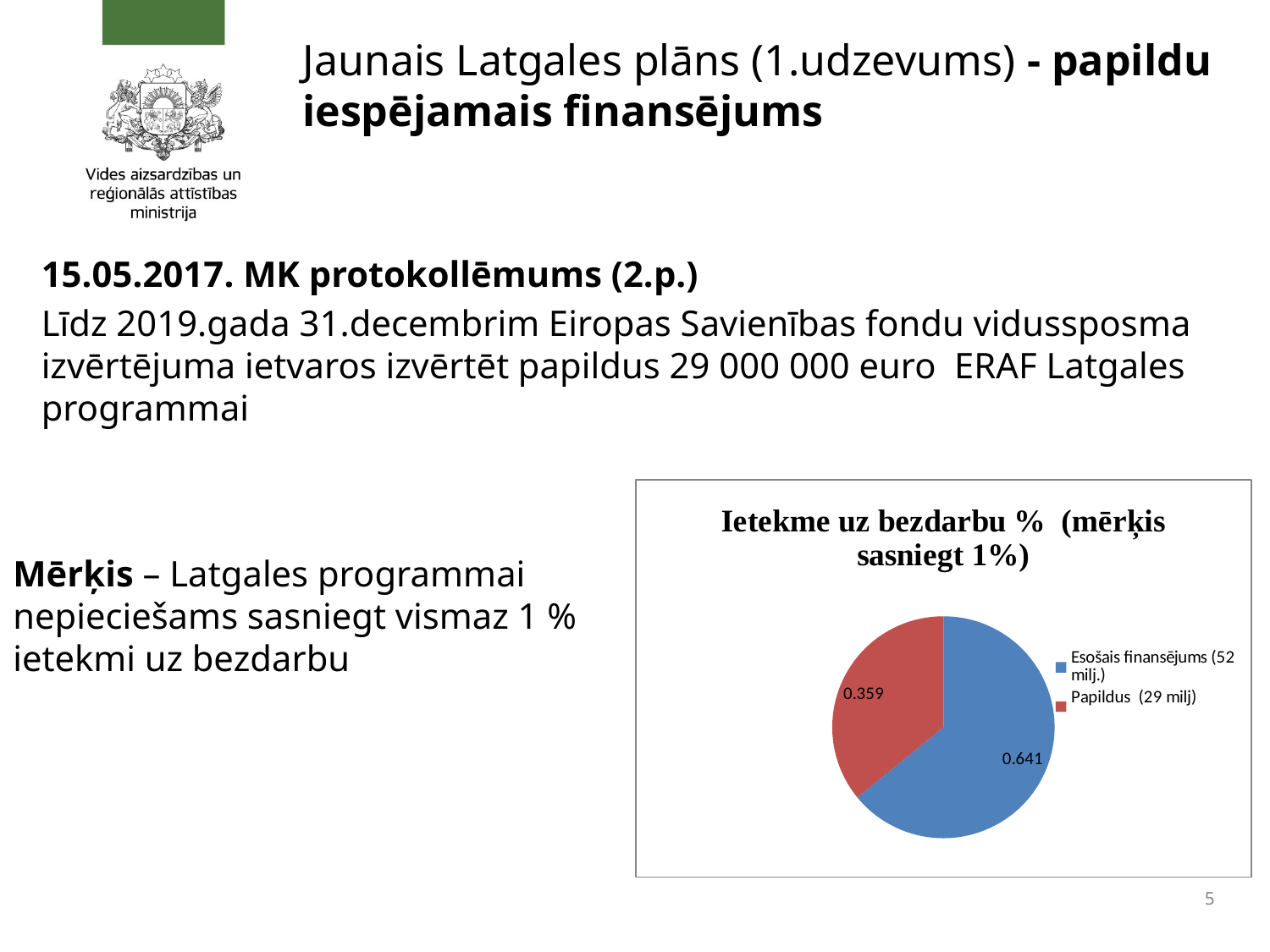
What is the value shown for Esošais finansējums (52 milj.)? 0.641 What is the title of the chart? Ietekme uz bezdarbu % (mērķis sasniegt 1%) What type of chart is shown on the slide? pie chart Which slice of the pie chart is the largest? Esošais finansējums (52 milj.) How many entries does the chart legend list? 2 What is the total of the two values shown on the pie chart? 1 Which slice of the pie chart is the smallest? Papildus (29 milj) What is the difference between the values for Esošais finansējums (52 milj.) and Papildus (29 milj)? 0.282 Which is larger, the value for Esošais finansējums (52 milj.) or for Papildus (29 milj)? Esošais finansējums (52 milj.) How many slices does the pie chart have? 2 What colour is the slice for Papildus (29 milj)? red What is the value shown for Papildus (29 milj)? 0.359